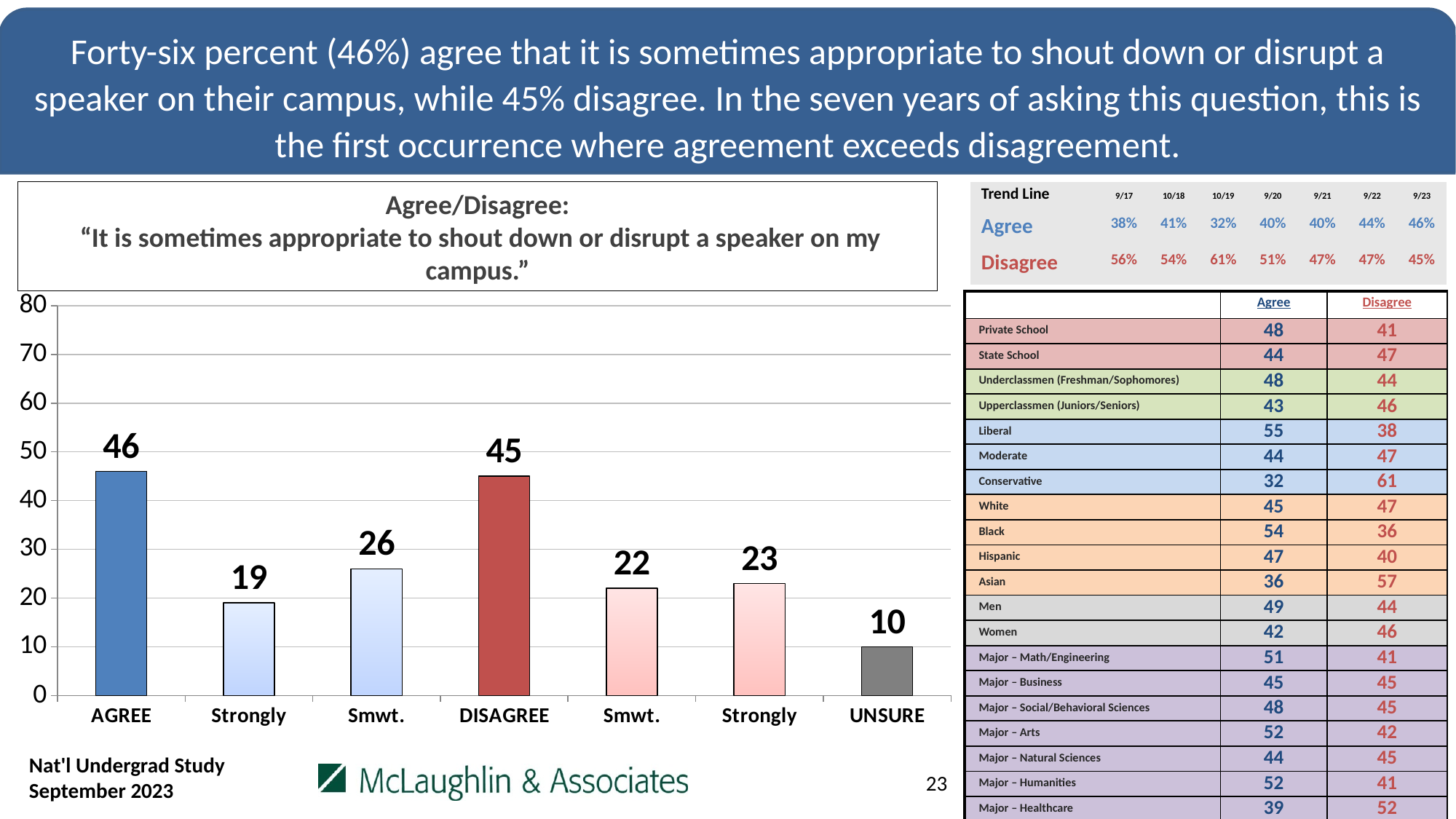
What is the value of the UNSURE bar? 10 Which bar has the highest value? AGREE What is the value of the second Smwt. bar (the one immediately to the right of DISAGREE)? 22 What is the value of the DISAGREE bar? 45 What is the difference between the AGREE bar and the DISAGREE bar? 1 What type of chart is shown on the slide? bar chart What is the value of the AGREE bar? 46 How many bars are shown in the chart? 7 Which is larger, the first Smwt. bar (next to AGREE) or the second Smwt. bar (next to DISAGREE)? the first Smwt. bar (26) Which bar has the lowest value? UNSURE What is the value of the first Strongly bar (the one immediately to the right of AGREE)? 19 What is the highest value shown on the vertical axis of the chart? 80